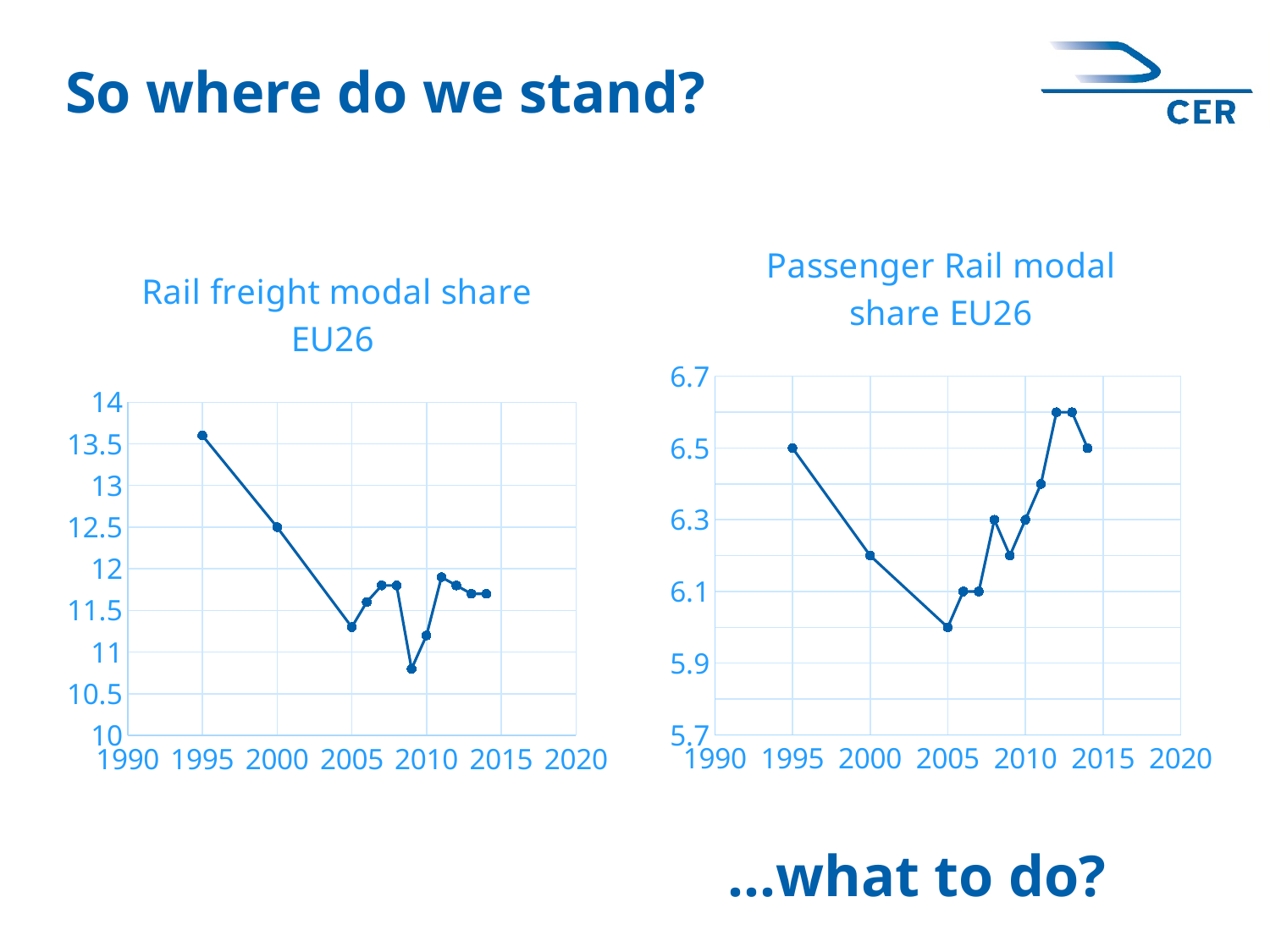
In the 'Passenger Rail modal share EU26' chart, which year has the lowest value? 2005 In the 'Rail freight modal share EU26' chart, which year has the lowest value? 2009 In the 'Rail freight modal share EU26' chart, which year has the highest value? 1995 In the 'Passenger Rail modal share EU26' chart, which is larger, the value for 2000 or the value for 2011? 2011 What kind of chart is the 'Rail freight modal share EU26' chart? line chart In the 'Passenger Rail modal share EU26' chart, what is the value for 1995? 6.5 How many data points are plotted in the 'Rail freight modal share EU26' chart? 12 In the 'Rail freight modal share EU26' chart, does the value rise or fall from 1995 to 2005? fall In the 'Rail freight modal share EU26' chart, is the value for 2009 greater or less than 11? less In the 'Rail freight modal share EU26' chart, what is the value for 2000? 12.5 In the 'Passenger Rail modal share EU26' chart, is the value for 2012 greater or less than 6.5? greater In the 'Passenger Rail modal share EU26' chart, does the value rise or fall from 2005 to 2012? rise